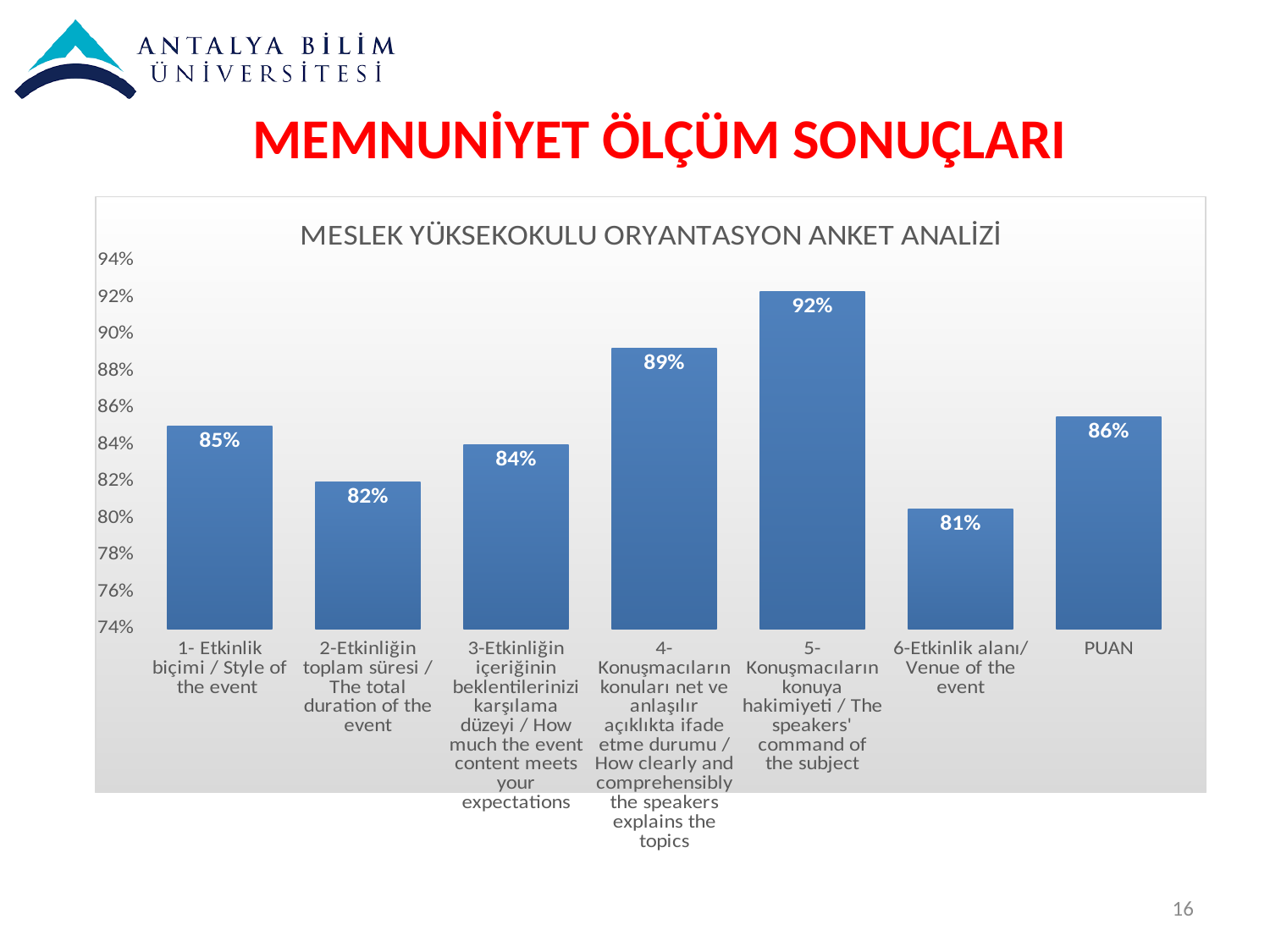
How many categories are shown on the x axis? 7 What is the difference between the value for 'PUAN' and the value for '2-Etkinliğin toplam süresi / The total duration of the event'? 4% What is the title of the chart? MESLEK YÜKSEKOKULU ORYANTASYON ANKET ANALİZİ What is the value for '6-Etkinlik alanı/ Venue of the event'? 81% What is the value for '2-Etkinliğin toplam süresi / The total duration of the event'? 82% Which category has the lowest value? 6-Etkinlik alanı/ Venue of the event What kind of chart is shown on the slide? bar chart What is the value for 'PUAN'? 86% Which is larger: the value for '1- Etkinlik biçimi / Style of the event' or the value for '3-Etkinliğin içeriğinin beklentilerinizi karşılama düzeyi / How much the event content meets your expectations'? 1- Etkinlik biçimi / Style of the event Which category has the highest value? 5-Konuşmacıların konuya hakimiyeti / The speakers' command of the subject Is the value for '4-Konuşmacıların konuları net ve anlaşılır açıklıkta ifade etme durumu / How clearly and comprehensibly the speakers explains the topics' greater or less than 86%? greater What is the difference between the value for '5-Konuşmacıların konuya hakimiyeti / The speakers' command of the subject' and the value for '6-Etkinlik alanı/ Venue of the event'? 11%